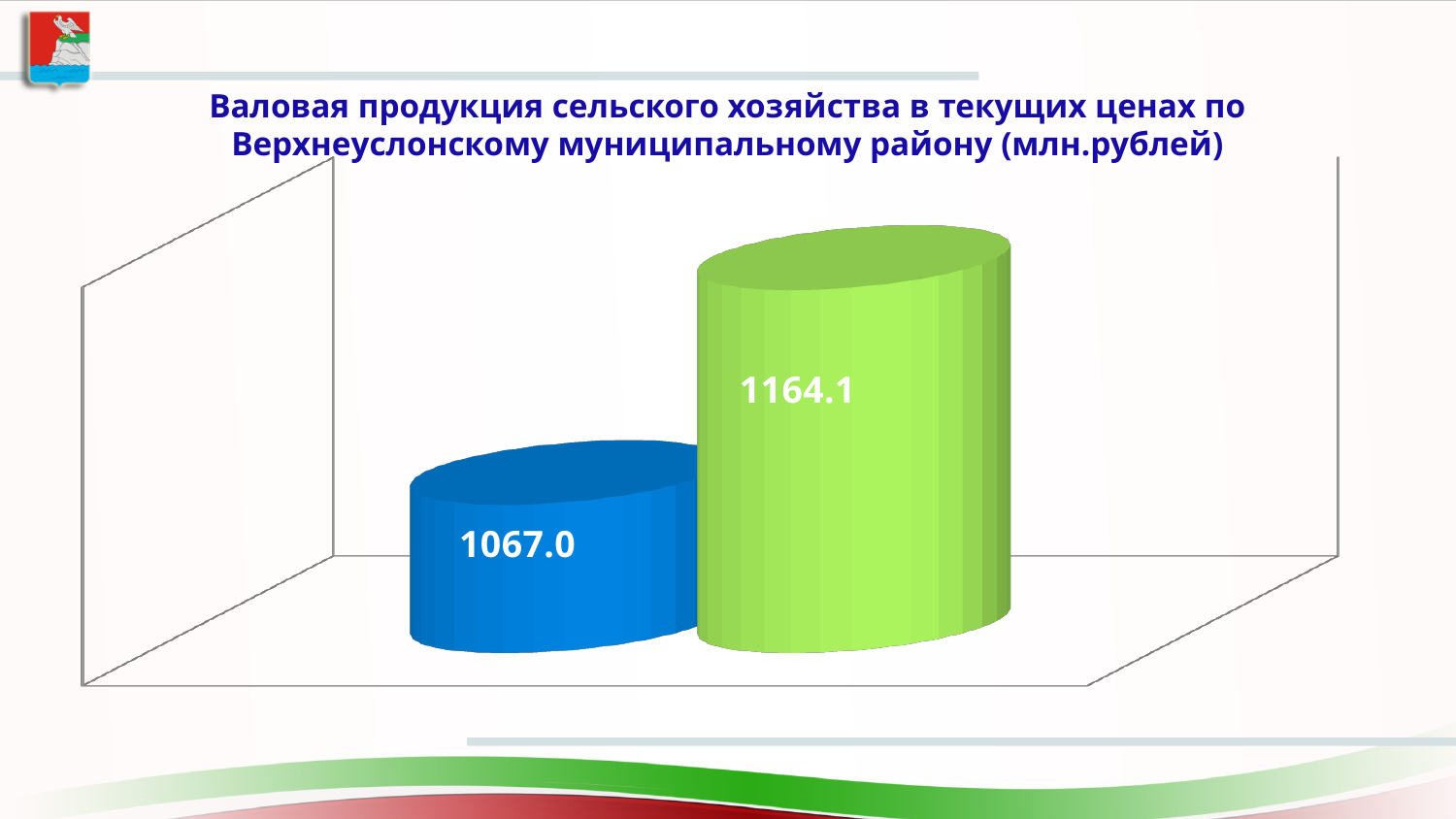
What is the total of the two values shown on the chart? 2231.1 How many bars are plotted on the chart? 2 What colour is the bar with the value 1164.1? green Do the values rise or fall from the left bar to the right bar? rise Which bar has the higher value, the blue one or the green one? the green bar Is the value of the left bar larger or smaller than the value of the right bar? smaller What is the difference between the value of the green bar and the value of the blue bar? 97.1 What value is shown on the blue bar? 1067.0 Which bar has the lower value, the blue one or the green one? the blue bar In what units are the values on the chart expressed, according to the title? млн.рублей What value is shown on the green bar? 1164.1 What kind of chart is shown on the slide? bar chart